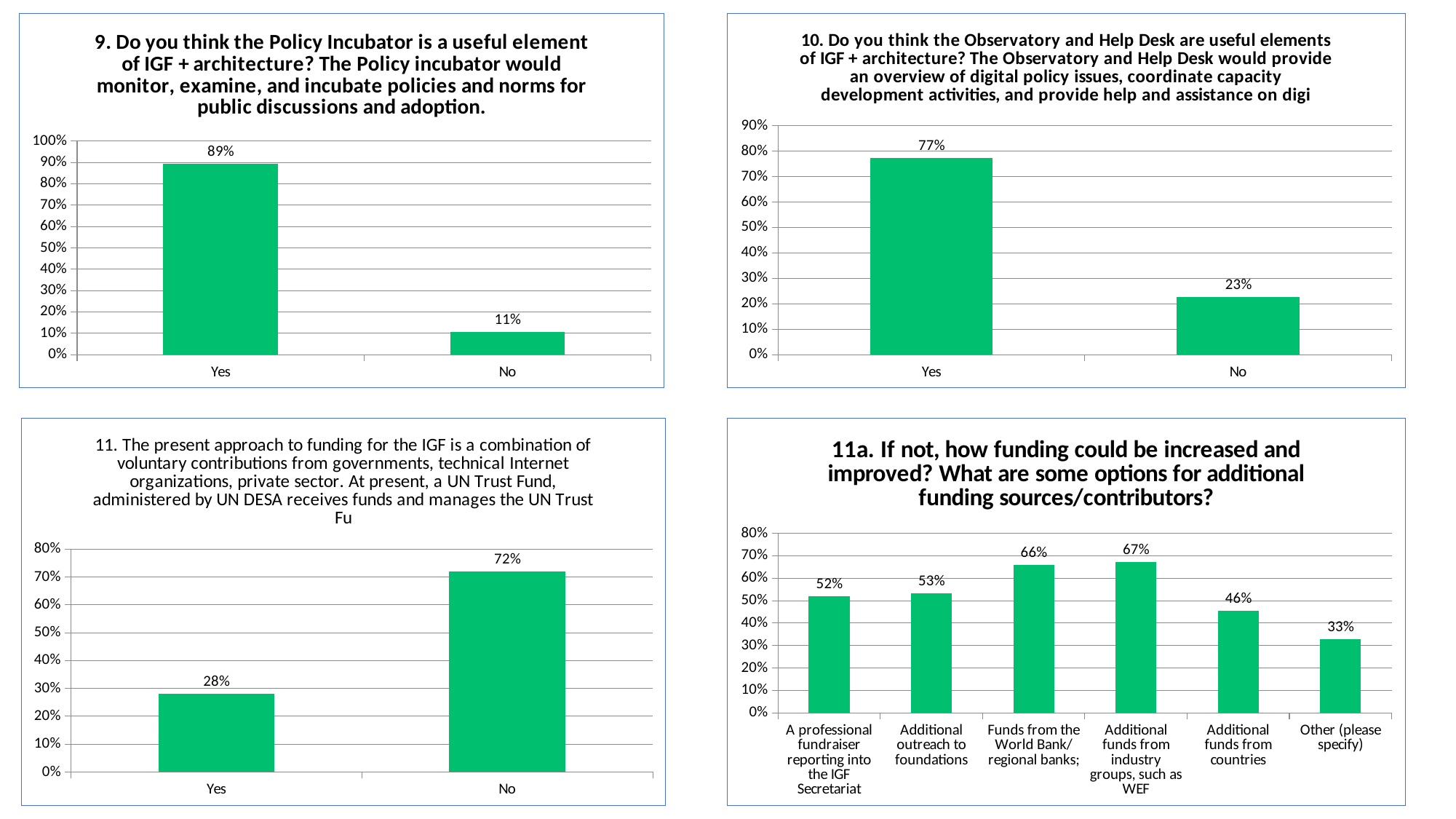
In the top-left chart (question 9, Policy Incubator), what is the value for No? 11% In the top-right chart (question 10, Observatory and Help Desk), what is the value for Yes? 77% In the top-left chart (question 9, Policy Incubator), what is the value for Yes? 89% In the bottom-left chart (question 11, funding approach), which category is highest? No In the bottom-right chart (question 11a, funding options), which category has the lowest value? Other (please specify) In the top-right chart (question 10, Observatory and Help Desk), what is the difference between the Yes and No values? 54% In the bottom-right chart (question 11a, funding options), how many categories are shown? 6 What kind of chart is the top-left chart (question 9, Policy Incubator)? Bar chart In the bottom-right chart (question 11a, funding options), which is larger: Additional outreach to foundations or Additional funds from countries? Additional outreach to foundations In the bottom-right chart (question 11a, funding options), what is the value for Funds from the World Bank/regional banks? 66% In the bottom-right chart (question 11a, funding options), what is the difference between Additional funds from industry groups, such as WEF and A professional fundraiser reporting into the IGF Secretariat? 15% In the bottom-left chart (question 11, funding approach), what is the value for Yes? 28%